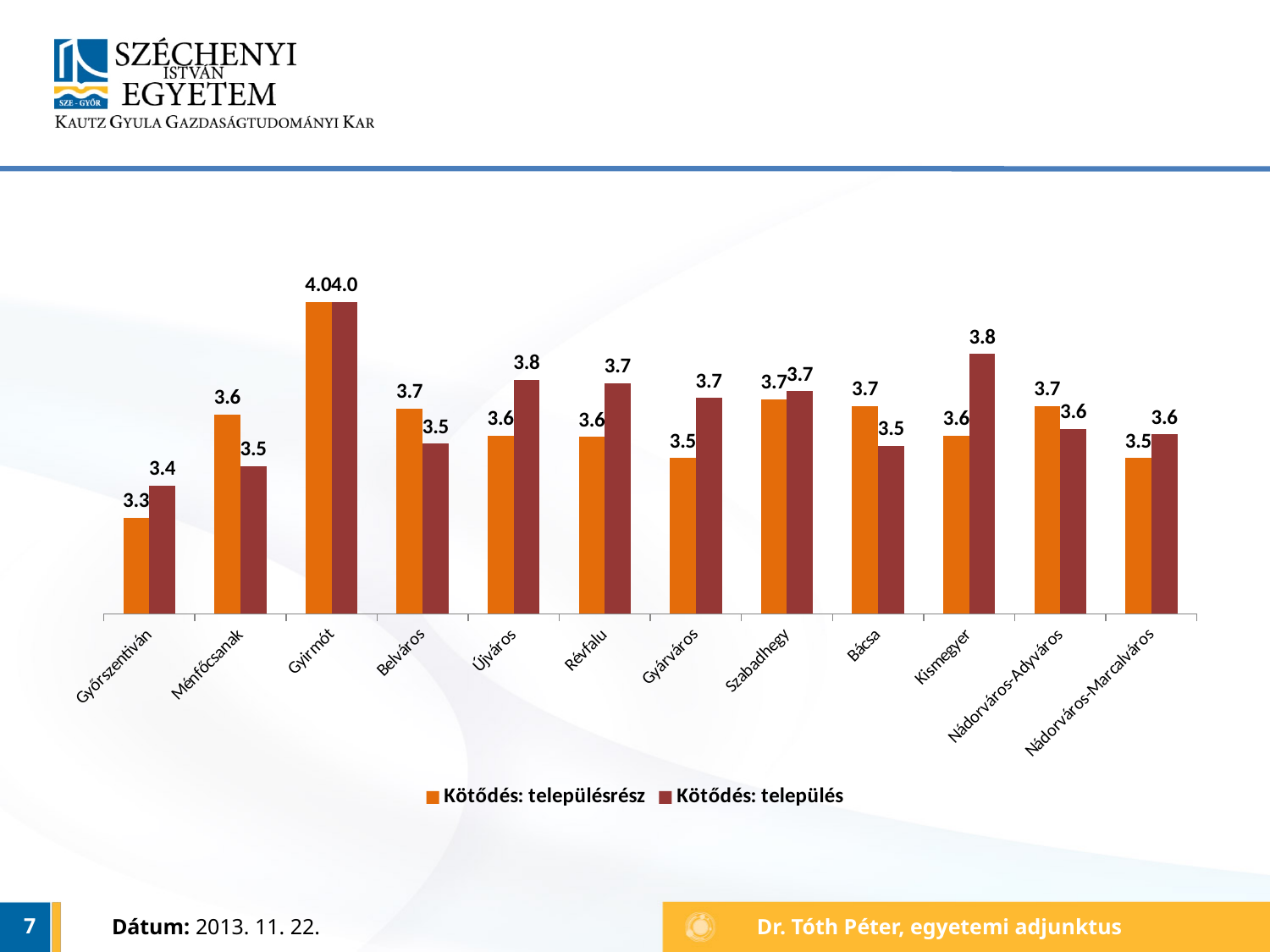
What kind of chart is shown on the slide? Bar chart For Gyárváros, which is larger: Kötődés: településrész or Kötődés: település? Kötődés: település Which category has the highest value for Kötődés: településrész? Gyirmót What is the value of Kötődés: település for Kismegyer? 3.8 How many series does the legend list? 2 How many categories are shown on the x axis? 12 What is the value of Kötődés: településrész for Belváros? 3.7 For Bácsa, which is larger: Kötődés: településrész or Kötődés: település? Kötődés: településrész Which category has the lowest value for Kötődés: település? Győrszentiván What is the value of Kötődés: településrész for Győrszentiván? 3.3 What is the difference between Kötődés: település and Kötődés: településrész for Újváros? 0.2 What is the difference between Kötődés: településrész and Kötődés: település for Belváros? 0.2